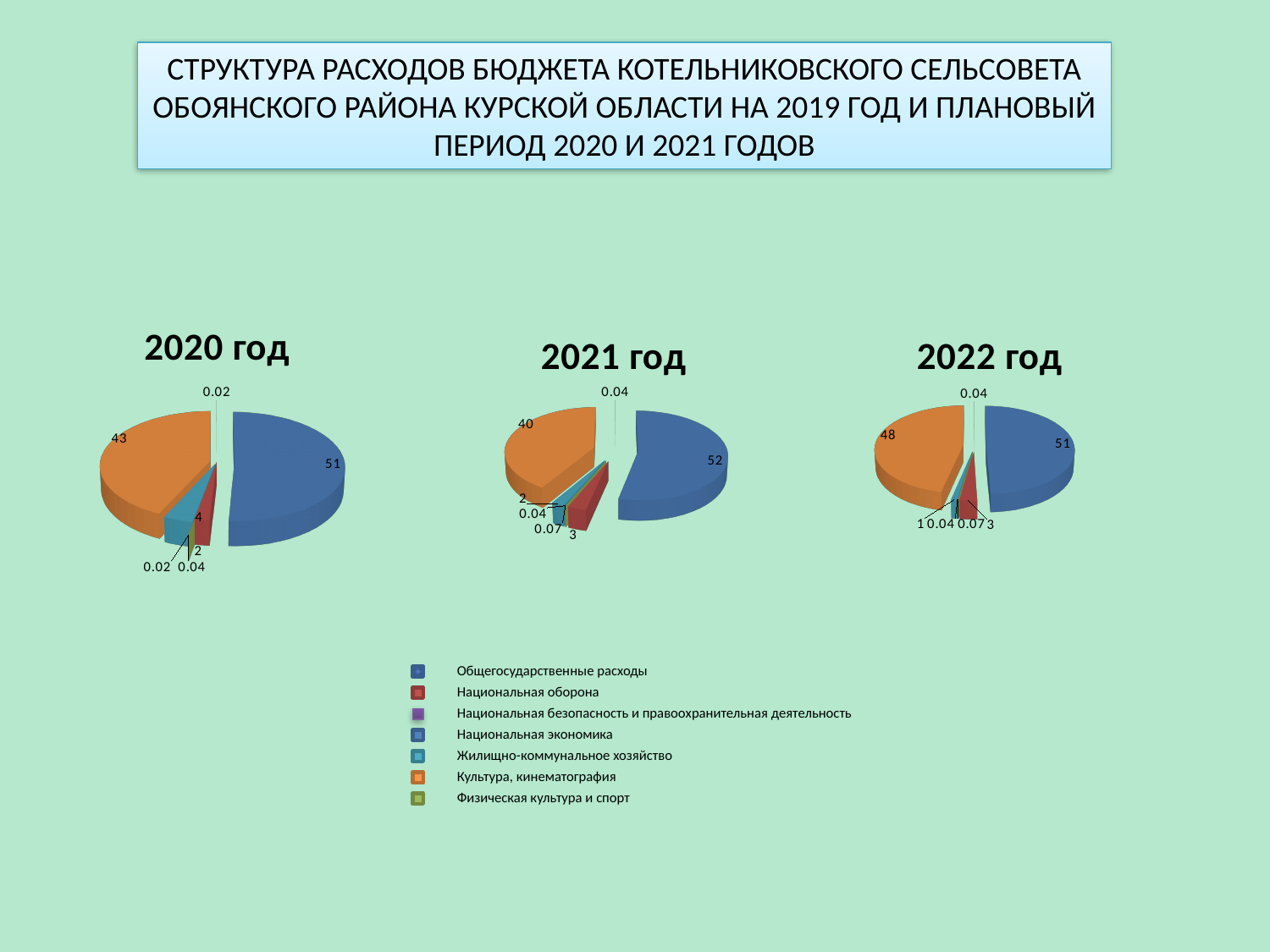
How many categories does the shared legend list for the pie charts? 7 In the 2021 год pie chart, what is the value shown for Культура, кинематография? 40 What type of chart is used for the 2020 год, 2021 год and 2022 год charts? pie chart In the 2022 год pie chart, which category has the largest slice? Общегосударственные расходы In the 2020 год pie chart, what is the value shown for Общегосударственные расходы? 51 How many pie charts are shown on the slide? 3 In the 2021 год pie chart, which is larger: Общегосударственные расходы or Культура, кинематография? Общегосударственные расходы In the 2022 год pie chart, what is the value shown for Культура, кинематография? 48 Is the value for Культура, кинематография larger in the 2020 год chart or in the 2022 год chart? 2022 год In the 2022 год pie chart, what is the difference between the values for Общегосударственные расходы and Культура, кинематография? 3 In the 2021 год pie chart, what is the value shown for Общегосударственные расходы? 52 In the 2020 год pie chart, what is the difference between the values for Общегосударственные расходы and Культура, кинематография? 8